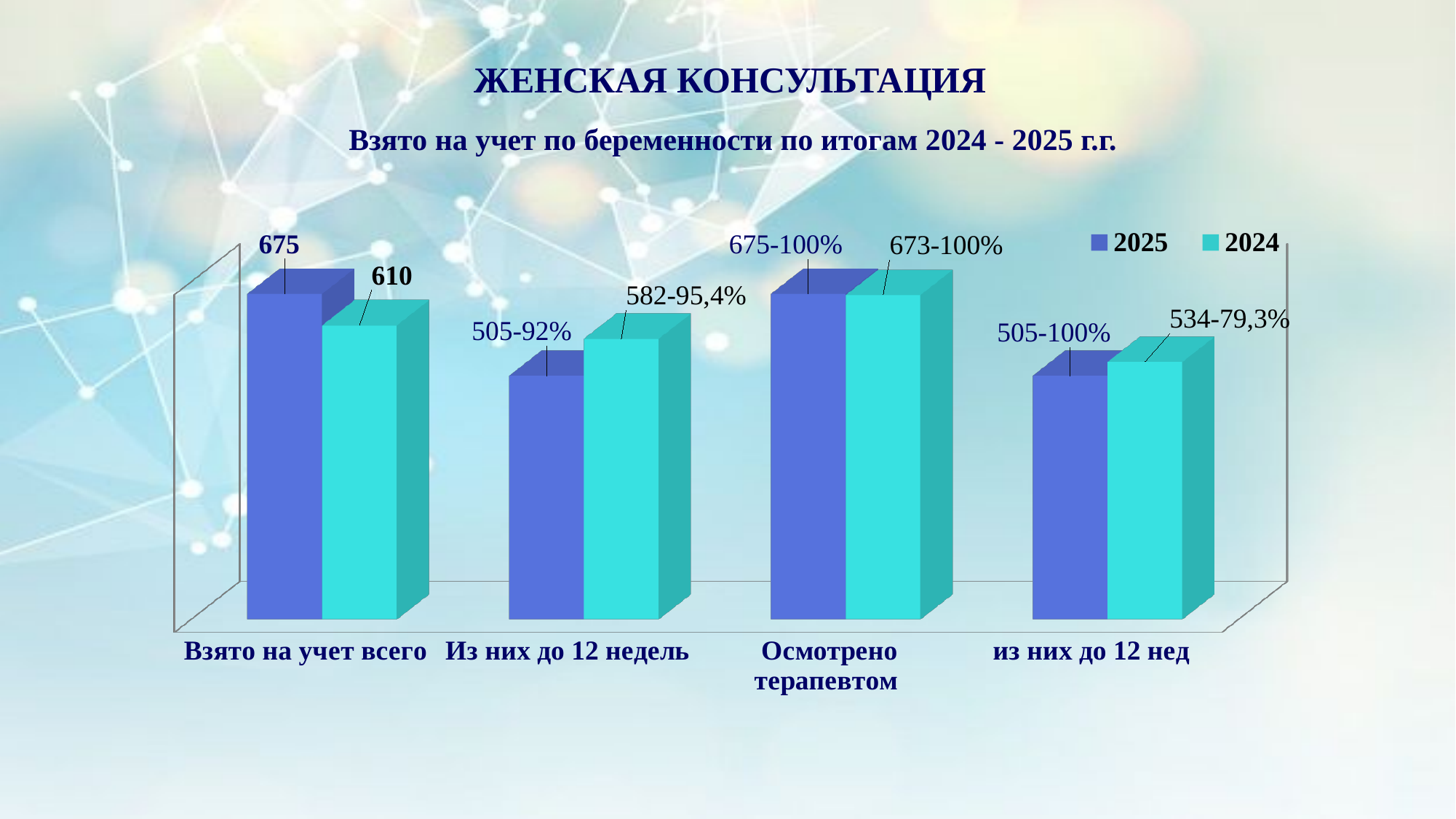
What is the data label for 2024 in the category "Из них до 12 недель"? 582-95,4% What is the value for 2024 in the category "Взято на учет всего"? 610 What is the data label for 2024 in the category "Осмотрено терапевтом"? 673-100% In the category "Из них до 12 недель", which series has the larger value, 2025 or 2024? 2024 What type of chart is shown on the slide? bar chart What is the data label for 2024 in the category "из них до 12 нед"? 534-79,3% Which series is shown in the darker blue colour according to the legend? 2025 What is the difference between the 2025 and 2024 values in the category "Взято на учет всего"? 65 What is the value for 2025 in the category "Взято на учет всего"? 675 How many categories are shown on the x axis? 4 What is the data label for 2025 in the category "Из них до 12 недель"? 505-92% How many series does the legend list? 2